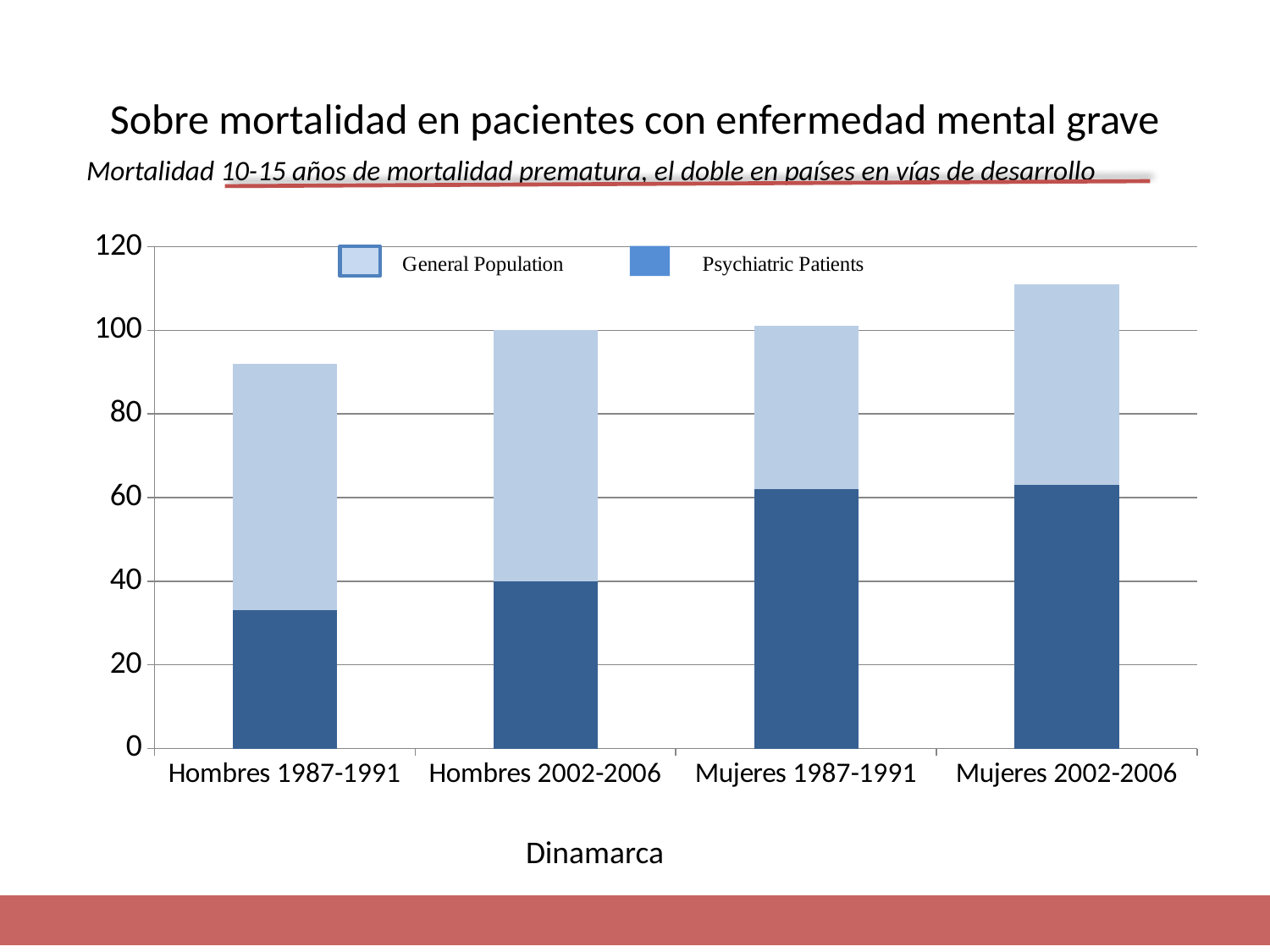
Is the Psychiatric Patients value for Hombres 1987-1991 greater or less than 40? less Which has the larger Psychiatric Patients value, Hombres 1987-1991 or Hombres 2002-2006? Hombres 2002-2006 Do the total bar heights rise or fall from left to right across the categories? rise How many series does the chart's legend list? 2 What are the two series named in the chart's legend? General Population and Psychiatric Patients Is the total height of the Mujeres 2002-2006 bar greater or less than 100? greater Is the total height of the Hombres 1987-1991 bar greater or less than 100? less Which category has the shortest stacked bar overall? Hombres 1987-1991 What kind of chart is shown on the slide? Stacked bar chart Which category has the tallest stacked bar overall? Mujeres 2002-2006 How many categories are shown on the x axis of the chart? 4